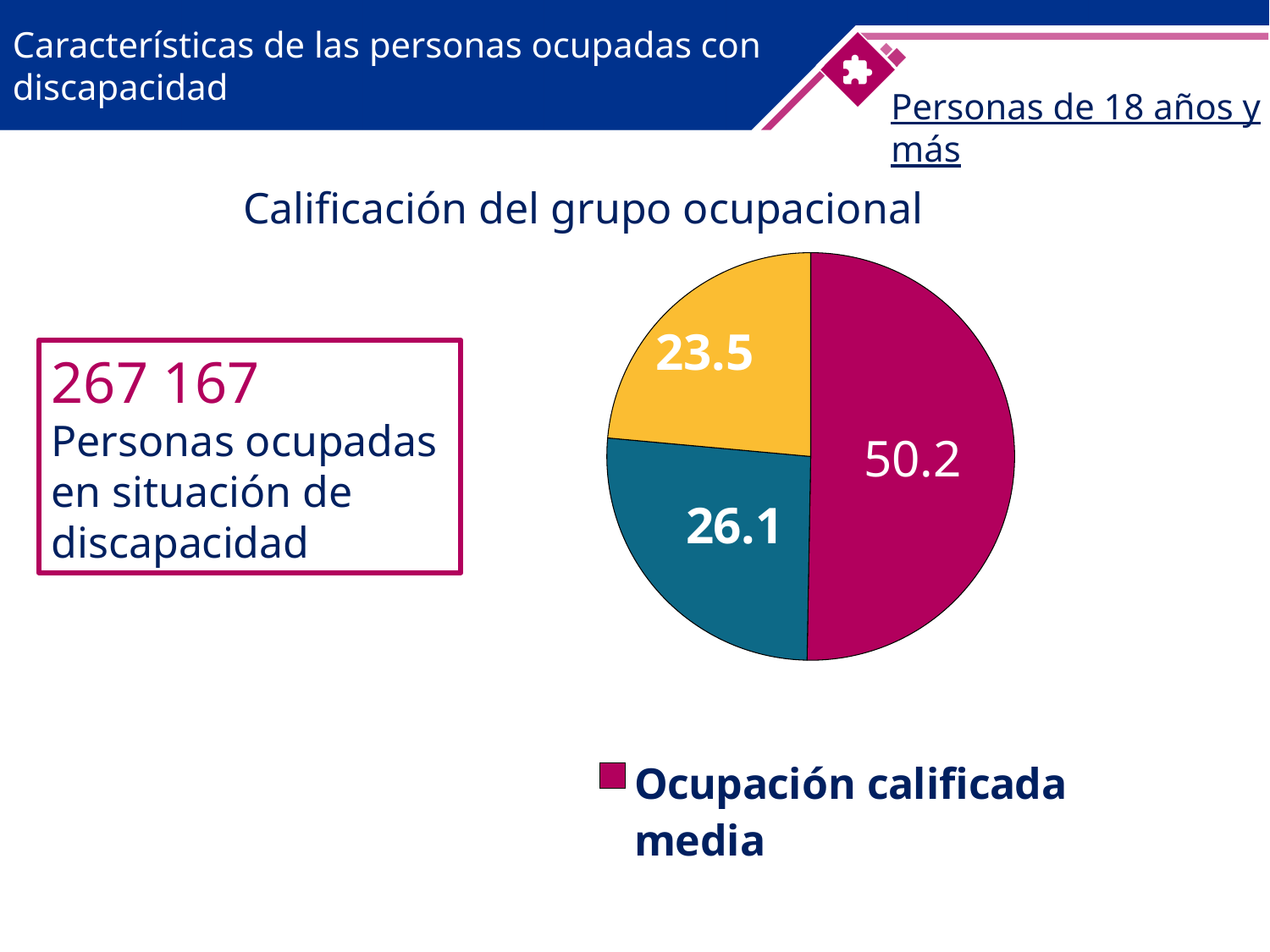
What is the value shown for the "Ocupación calificada media" slice of the pie chart? 50.2 What is the difference between the teal slice (26.1) and the yellow slice (23.5) of the pie chart? 2.6 Which is larger on the pie chart: the teal slice or the yellow slice? the teal slice (26.1) Is the value for "Ocupación calificada media" greater or less than 50? greater What is the difference between the largest slice (50.2) and the smallest slice (23.5) of the pie chart? 26.7 What is the largest value shown on the pie chart? 50.2 What is the smallest value shown on the pie chart? 23.5 What kind of chart is shown on the slide? pie chart Which category does the legend of the pie chart list? Ocupación calificada media How many slices does the pie chart have? 3 What is the title of the pie chart? Calificación del grupo ocupacional What is the value shown on the yellow slice of the pie chart? 23.5